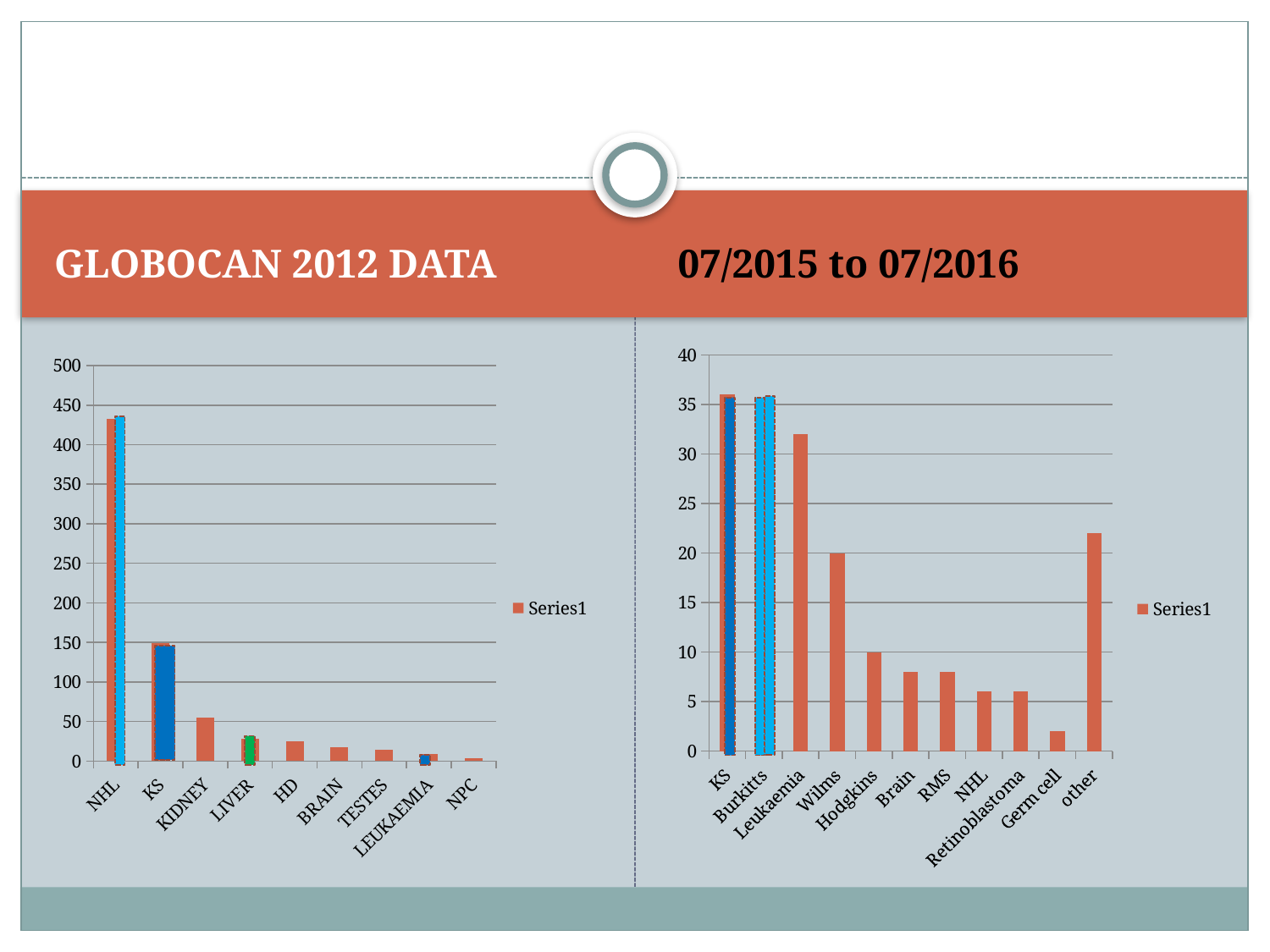
On the GLOBOCAN 2012 DATA chart, is the value for NHL greater or less than 400? greater On the 07/2015 to 07/2016 chart, which category has the lowest value? Germ cell What kind of chart is the 07/2015 to 07/2016 chart? bar chart On the GLOBOCAN 2012 DATA chart, which category has the lowest value? NPC On the 07/2015 to 07/2016 chart, is the value for Leukaemia greater or less than 30? greater How many series does the legend of the 07/2015 to 07/2016 chart list? 1 On the GLOBOCAN 2012 DATA chart, which is larger, the value for KS or the value for LIVER? KS On the 07/2015 to 07/2016 chart, how many categories are shown on the x axis? 11 On the GLOBOCAN 2012 DATA chart, which category has the highest value? NHL On the 07/2015 to 07/2016 chart, which is larger, the value for other or the value for Wilms? other On the GLOBOCAN 2012 DATA chart, is the value for KIDNEY greater or less than 100? less On the GLOBOCAN 2012 DATA chart, how many categories are shown on the x axis? 9